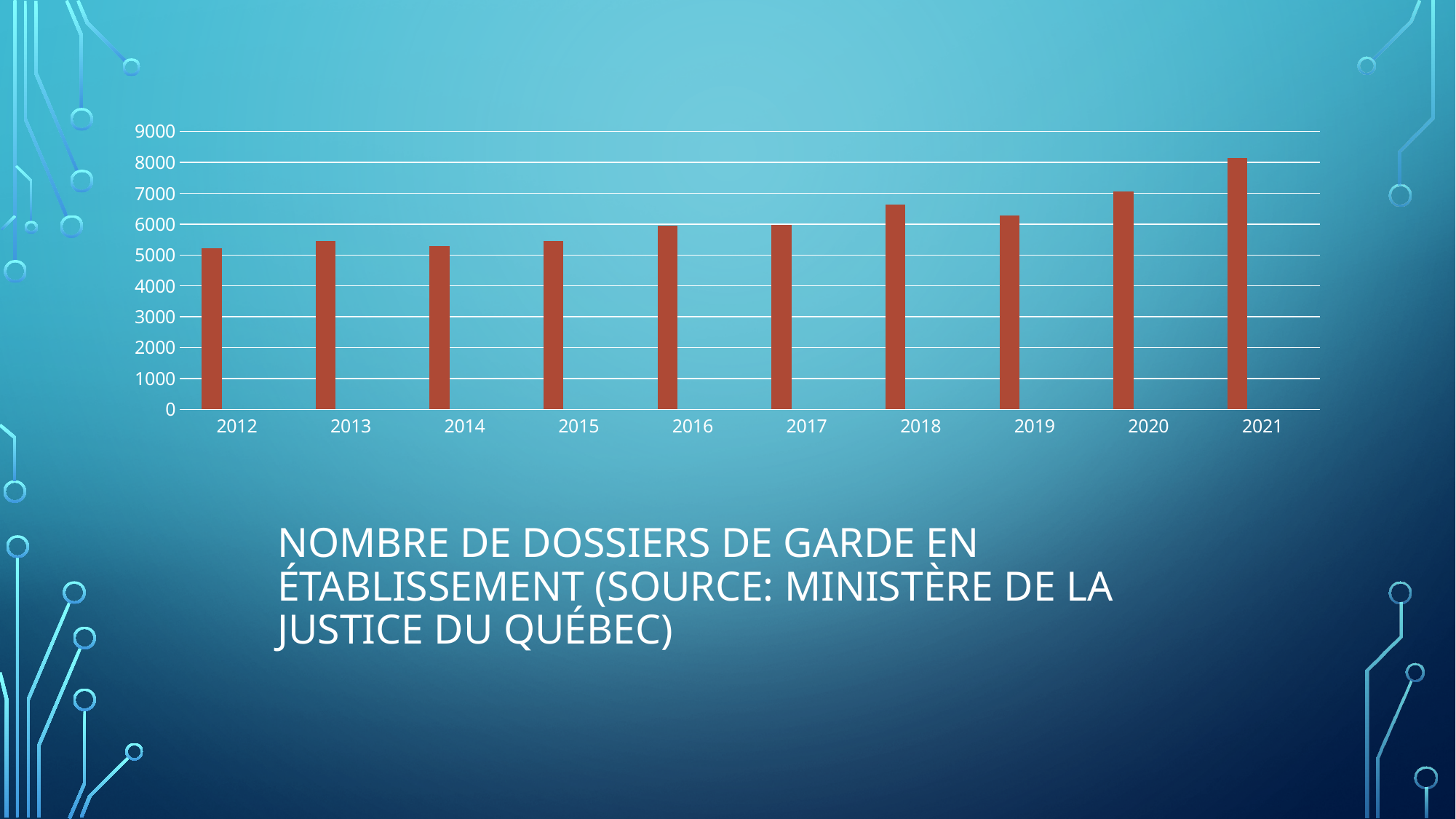
Is the value for 2021 greater or less than 8000? greater Which year has the highest number of dossiers in the chart? 2021 How many years are shown on the x axis of the chart? 10 Is the value for 2013 greater or less than 6000? less Is the value for 2018 greater or less than 6000? greater Which year has the larger value, 2018 or 2019? 2018 According to the slide, what is the source of the data in the chart? Ministère de la Justice du Québec Overall, do the values rise or fall from 2012 to 2021? rise Which year has the larger value, 2020 or 2012? 2020 What kind of chart is shown on the slide? bar chart